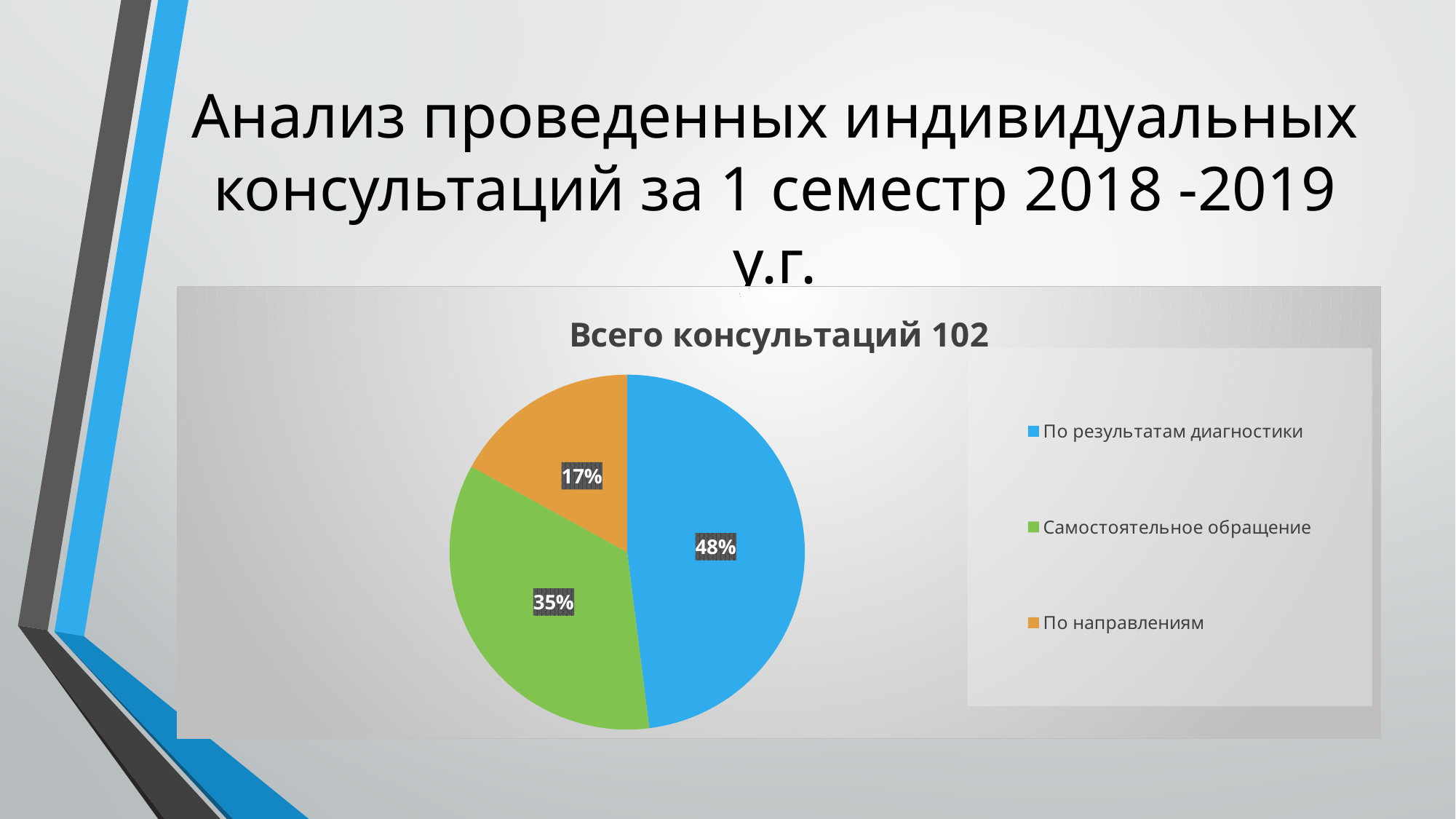
What kind of chart is shown on the slide? pie chart How many categories does the pie chart show? 3 What share of the pie does "Самостоятельное обращение" take? 35% Which category has the smallest slice of the pie? По направлениям What colour is the slice for "По направлениям"? orange Which category has the largest slice of the pie? По результатам диагностики What is the title of the chart? Всего консультаций 102 What share of the pie does "По результатам диагностики" take? 48% Which is larger: the share for "Самостоятельное обращение" or the share for "По направлениям"? Самостоятельное обращение What is the difference in percentage points between "По результатам диагностики" and "Самостоятельное обращение"? 13% What is the difference in percentage points between "Самостоятельное обращение" and "По направлениям"? 18% What share of the pie does "По направлениям" take? 17%